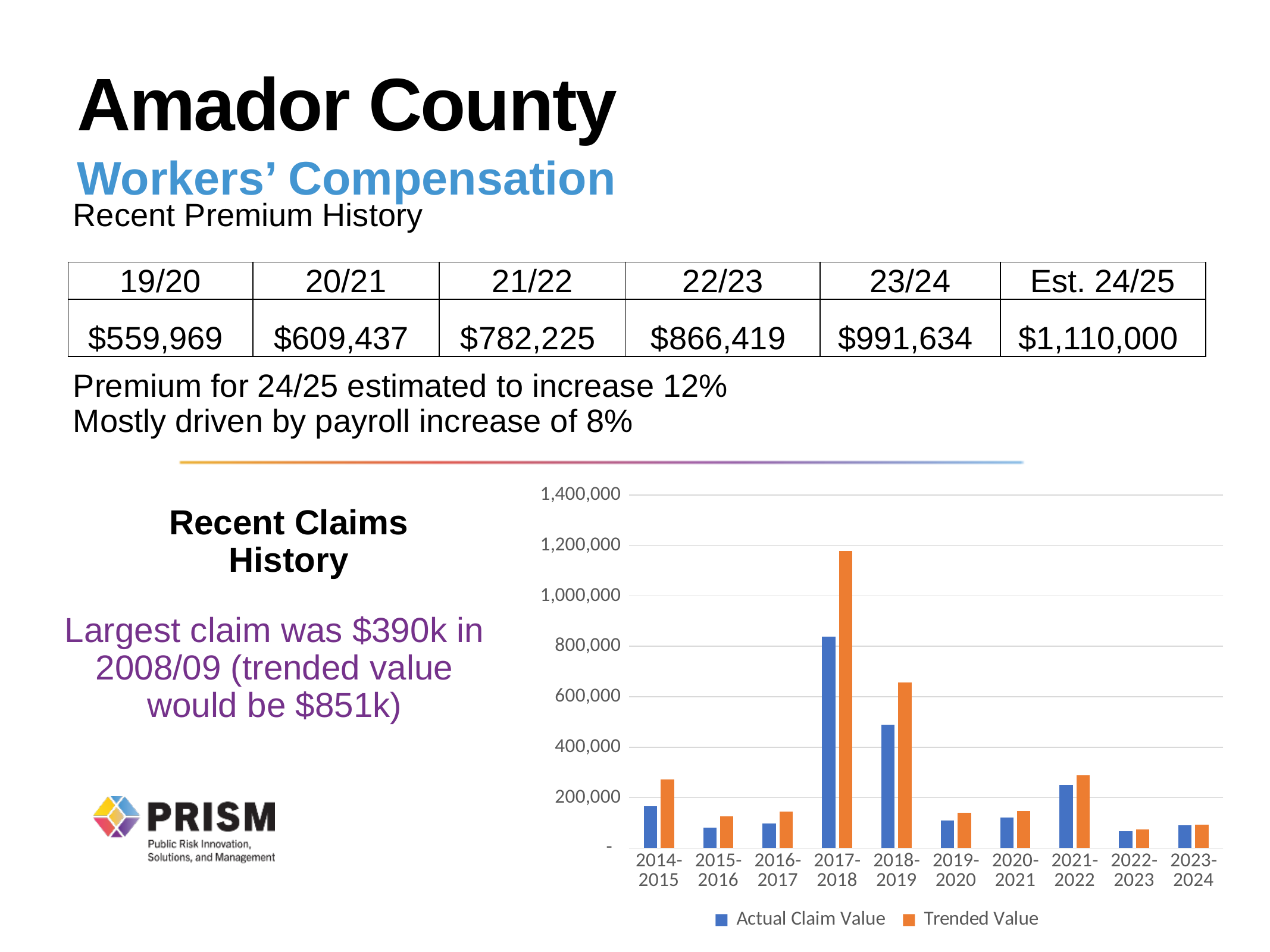
Is the Actual Claim Value for 2017-2018 greater or less than 1,000,000? less Which year has the lowest Actual Claim Value in the claims chart? 2022-2023 Is the Trended Value for 2017-2018 greater or less than 1,000,000? greater Which year has the highest Trended Value in the claims chart? 2017-2018 How many fiscal years are shown on the x axis of the claims chart? 10 What kind of chart is shown under Recent Claims History? bar chart What colour represents Trended Value in the claims chart? orange How many series does the legend of the claims chart list? 2 Which is larger, the Actual Claim Value for 2021-2022 or for 2014-2015? 2021-2022 Is the Trended Value for 2018-2019 greater or less than 600,000? greater Which year has the highest Actual Claim Value in the claims chart? 2017-2018